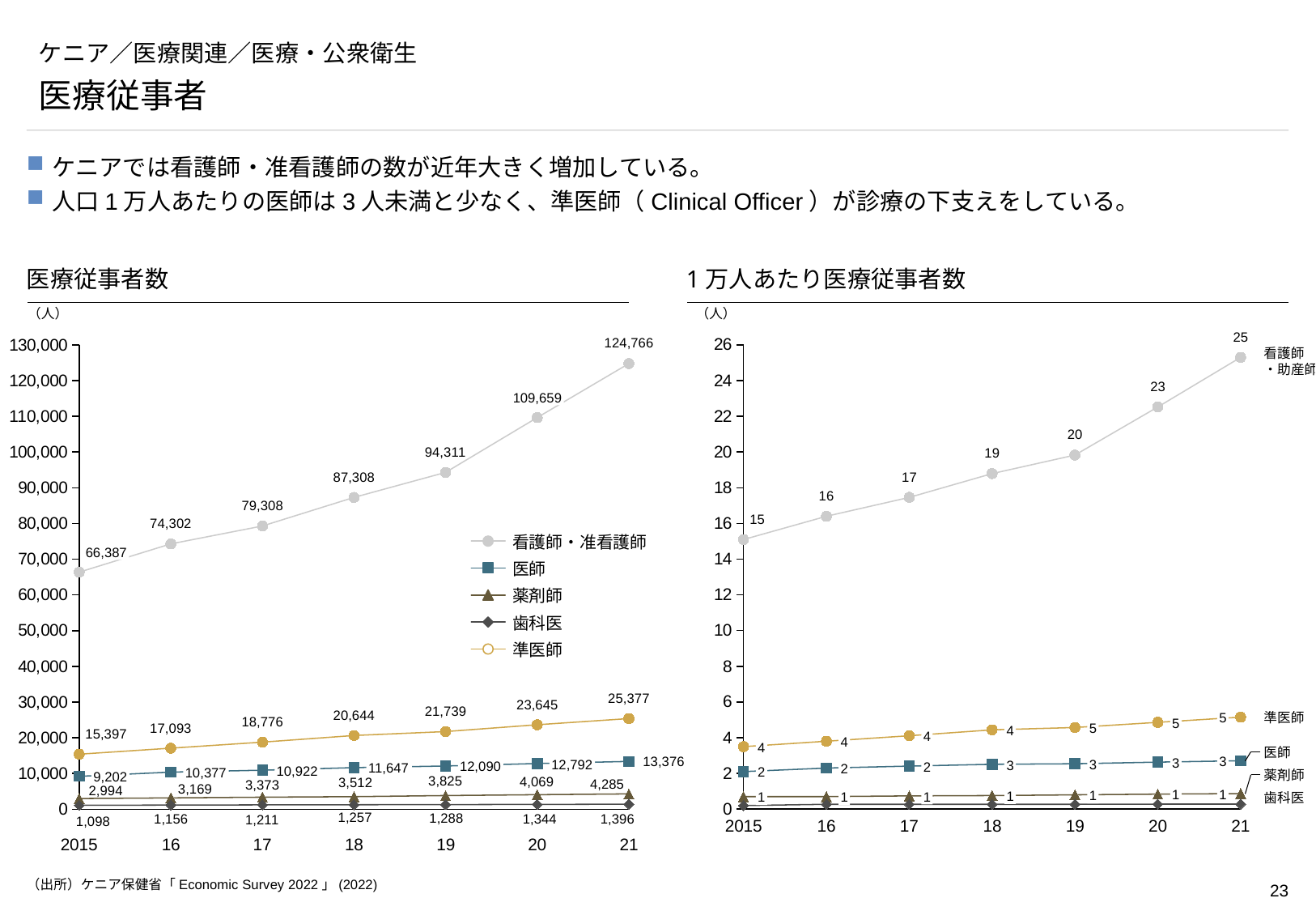
In the 医療従事者数 chart on the left, how many series does the legend list? 5 In the 1万人あたり医療従事者数 chart on the right, what is the value for 看護師・助産師 in 2020? 23 In the 医療従事者数 chart on the left, by how much did the number of 看護師・准看護師 increase from 2015 to 2021? 58,379 In the 1万人あたり医療従事者数 chart on the right, what is the value for 医師 in 2021? 3 In the 医療従事者数 chart on the left, does the number of 薬剤師 rise or fall from 2015 to 2021? rise In the 医療従事者数 chart on the left, which series has the lowest value in 2015? 歯科医 In the 医療従事者数 chart on the left, what is the value for 医師 in 2015? 9,202 In the 医療従事者数 chart on the left, which series has the highest value in 2021? 看護師・准看護師 In the 医療従事者数 chart on the left, what is the value for 歯科医 in 2021? 1,396 In the 医療従事者数 chart on the left, what is the value for 看護師・准看護師 in 2021? 124,766 In the 医療従事者数 chart on the left, what is the value for 準医師 in 2018? 20,644 What kind of chart is the 1万人あたり医療従事者数 chart on the right? line chart